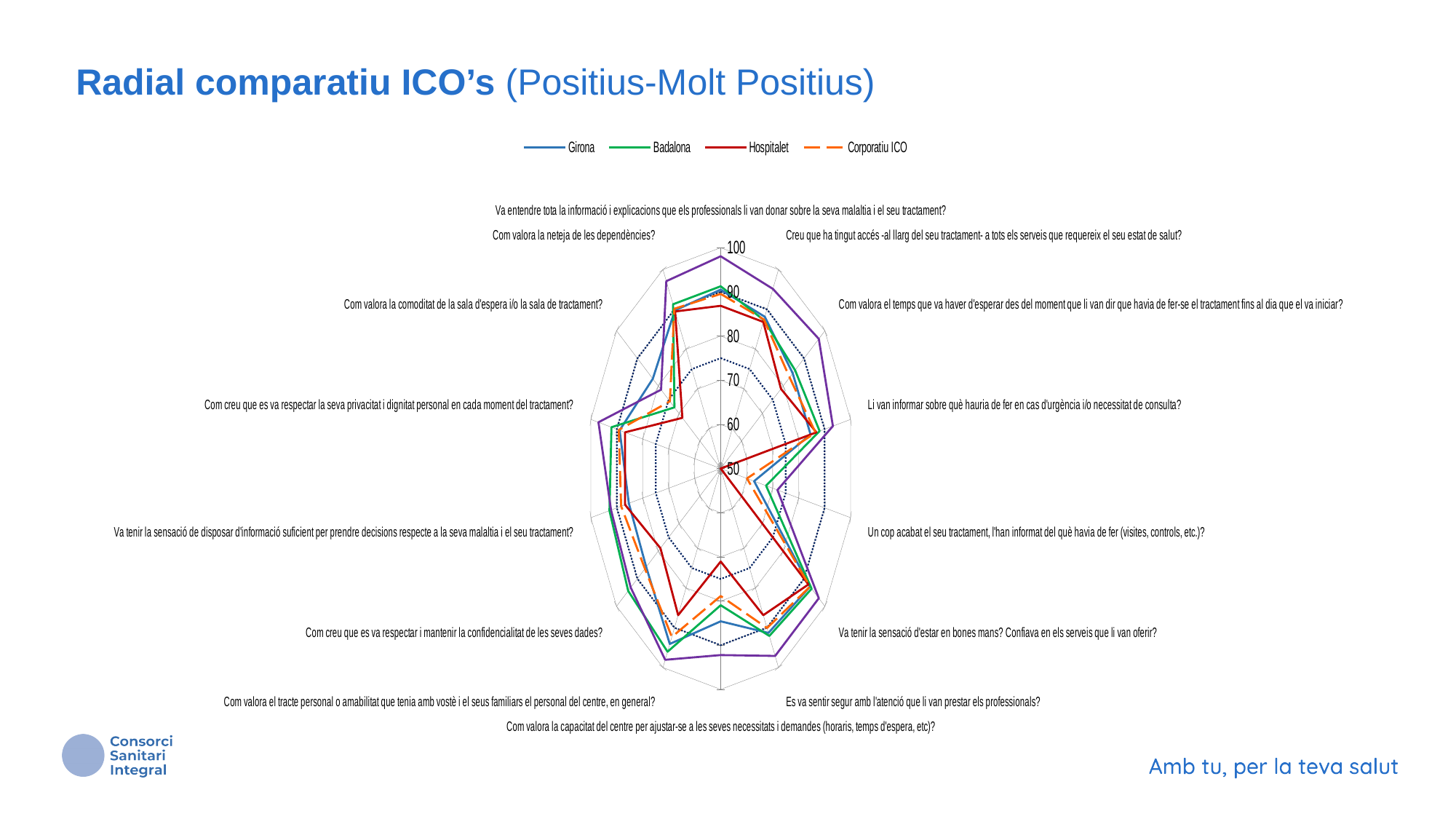
Which series in the legend is drawn with a dashed line? Corporatiu ICO How many series does the legend list? 4 How many categories (questions) are plotted around the radar chart? 14 What is the highest value shown on the radial axis of the chart? 100 Is the Hospitalet value for "Com valora la capacitat del centre per ajustar-se a les seves necessitats i demandes (horaris, temps d'espera, etc)?" greater or less than 80? less Is the Hospitalet value for "Va entendre tota la informació i explicacions que els professionals li van donar sobre la seva malaltia i el seu tractament?" greater or less than 80? greater Is the Badalona value for "Com valora la neteja de les dependències?" greater or less than 80? greater What kind of chart is shown on the slide? Radar chart For "Un cop acabat el seu tractament, l'han informat del què havia de fer (visites, controls, etc.)?", which series has the larger value, Badalona or Hospitalet? Badalona For "Com valora la capacitat del centre per ajustar-se a les seves necessitats i demandes (horaris, temps d'espera, etc)?", which series has the larger value, Badalona or Hospitalet? Badalona